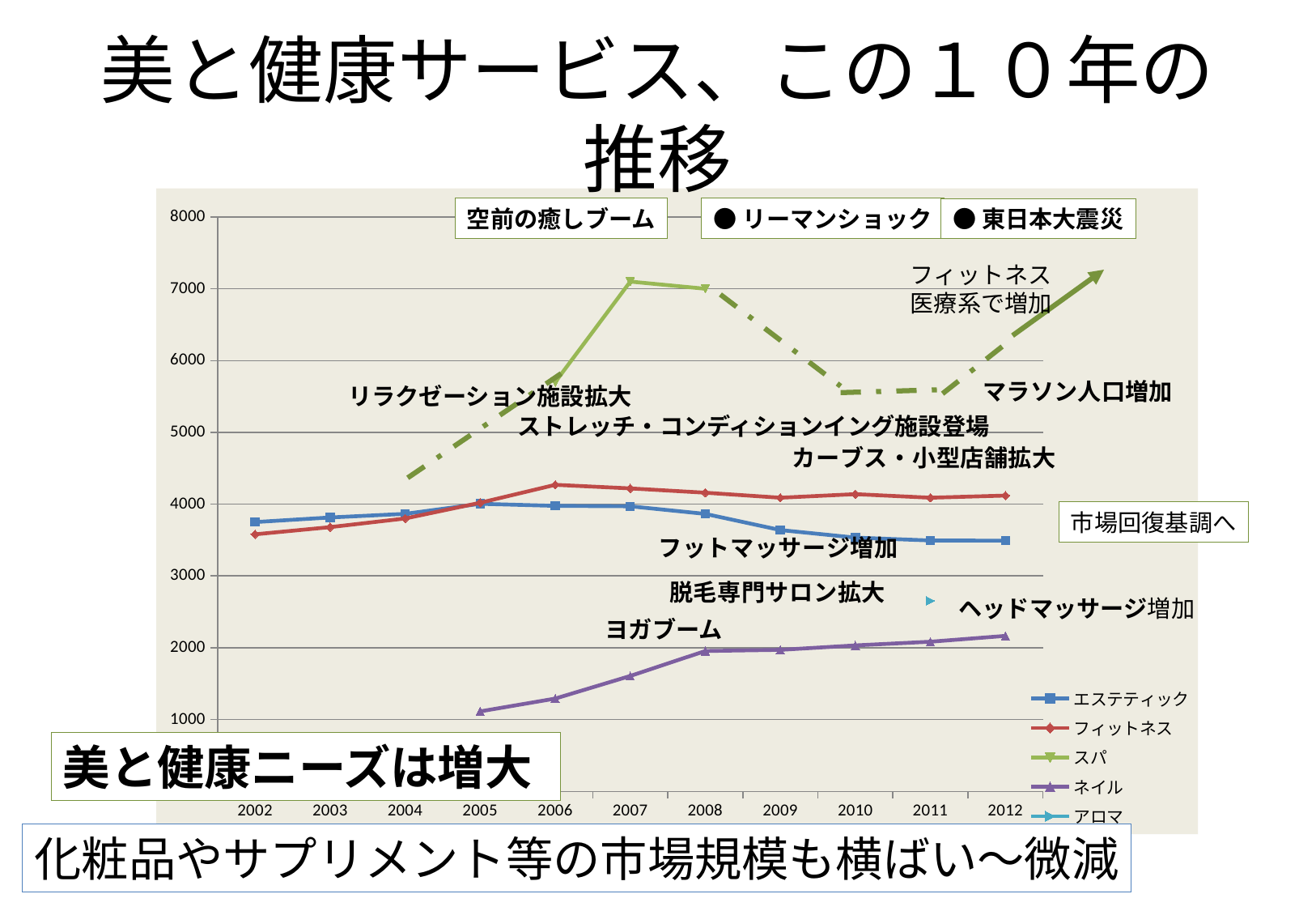
How many years are shown on the x axis? 11 How many series does the legend list? 5 Which series is drawn in green? スパ Does the ネイル line rise or fall from 2005 to 2012? rise In 2012, which is higher: フィットネス or エステティック? フィットネス Is the value for エステティック in 2012 greater or less than 4000? less What kind of chart is shown on the slide? line chart Is the value for スパ in 2007 greater or less than 6000? greater Which series has the lowest value in 2008? ネイル Which series has the highest value in 2007? スパ Is the value for フィットネス in 2006 greater or less than 4000? greater